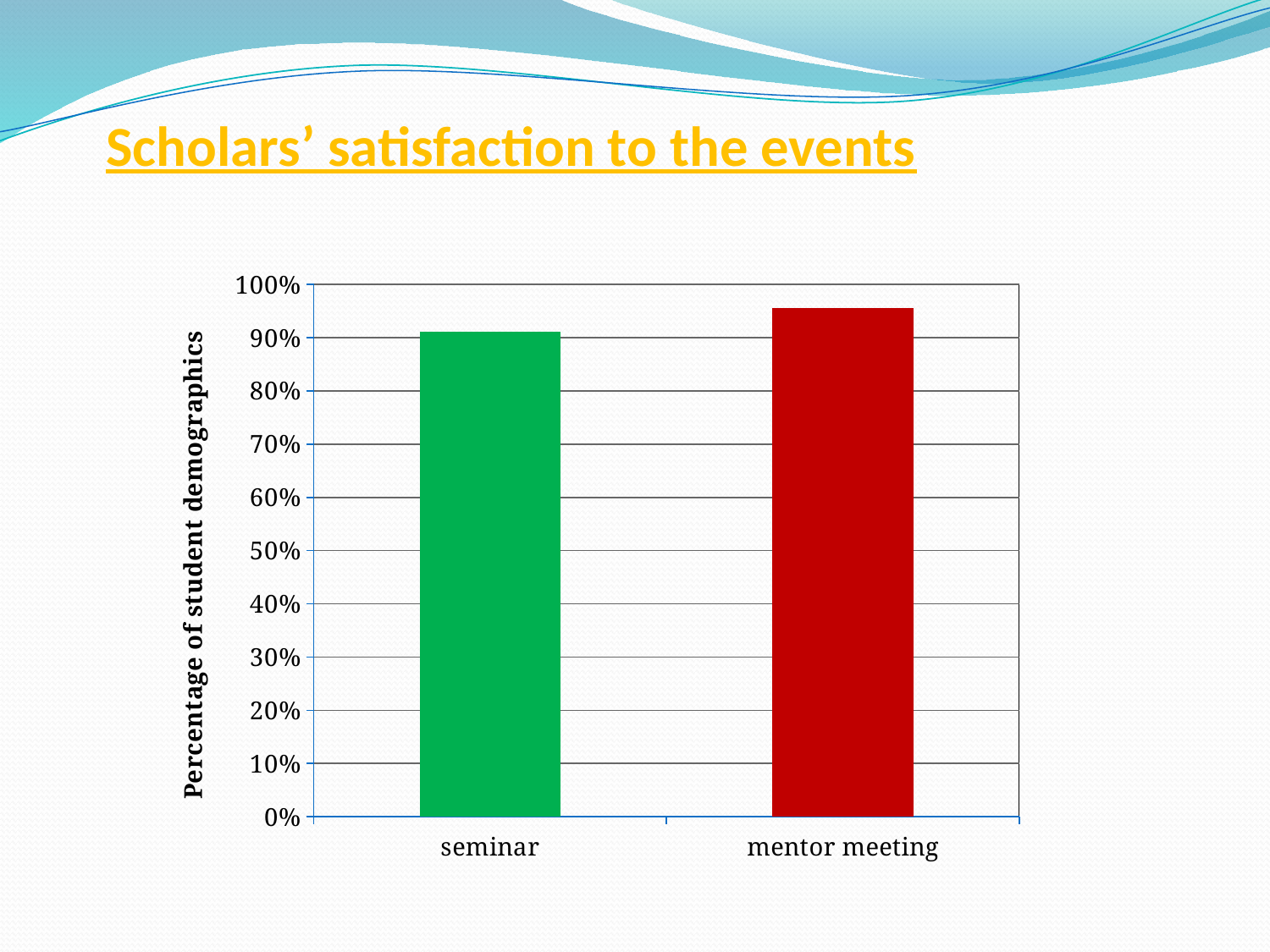
Which is larger, the value for seminar or the value for mentor meeting? mentor meeting What is the title of the slide containing the chart? Scholars' satisfaction to the events Is the value for seminar greater or less than 80%? greater Which category has the highest value in the chart? mentor meeting Is the value for mentor meeting greater or less than 90%? greater Is the value for seminar greater or less than 100%? less What kind of chart is shown on the slide? bar chart Which category has the lowest value in the chart? seminar How many categories are shown on the x axis of the chart? 2 What is the label on the y axis of the chart? Percentage of student demographics